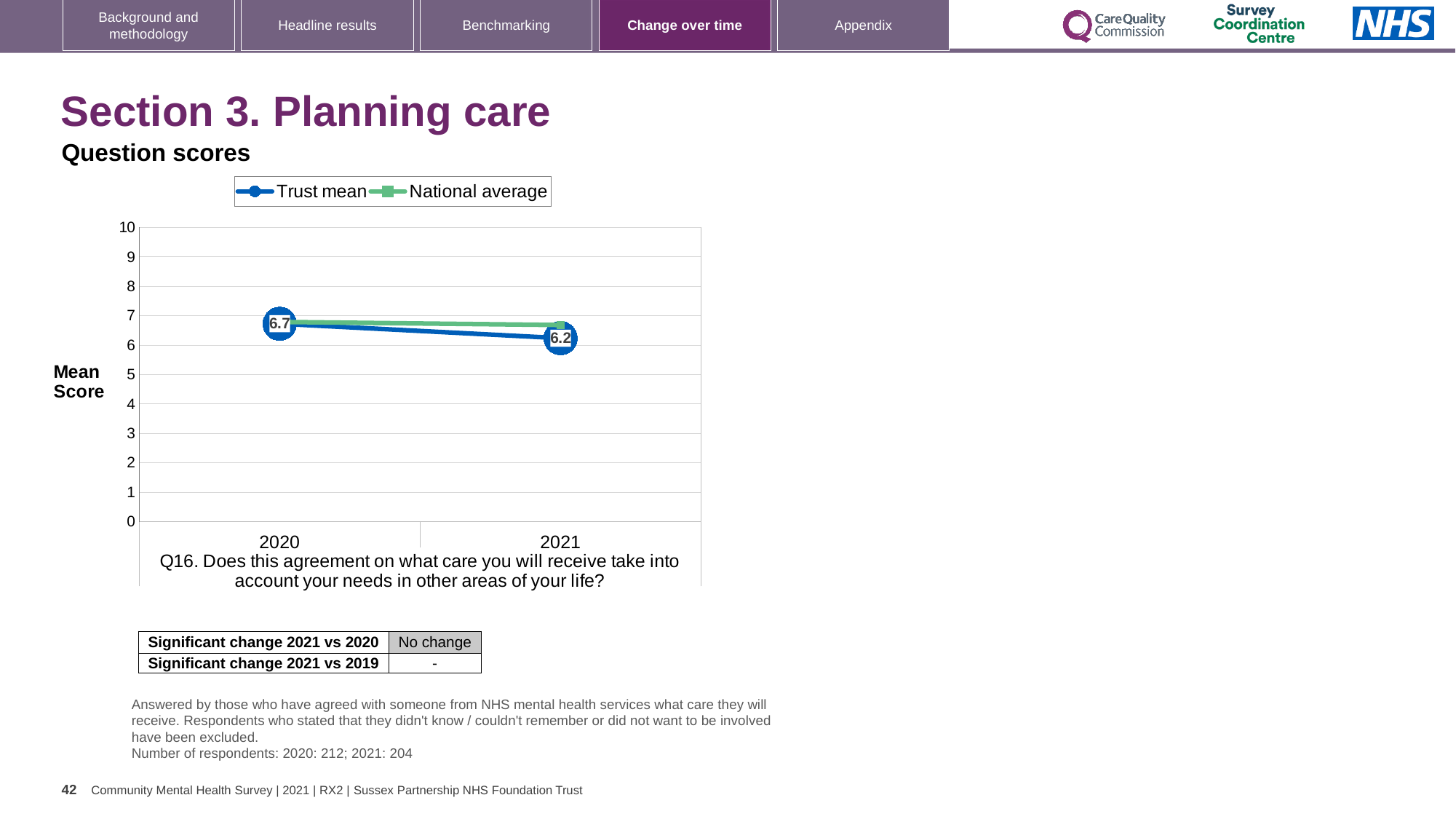
What kind of chart is shown on the slide? line chart How many years are plotted on the x axis of the chart? 2 Does the Trust mean score rise or fall from 2020 to 2021? fall How many series does the chart legend list? 2 Is the Trust mean value for 2021 greater or less than 8? less What is the Trust mean score for 2020? 6.7 In which year is the Trust mean score lowest? 2021 What is the Trust mean score for 2021? 6.2 By how much did the Trust mean score change from 2020 to 2021? 0.5 Which year has the higher Trust mean score, 2020 or 2021? 2020 What are the two series named in the chart legend? Trust mean and National average Is the National average value for 2021 greater or less than 5? greater